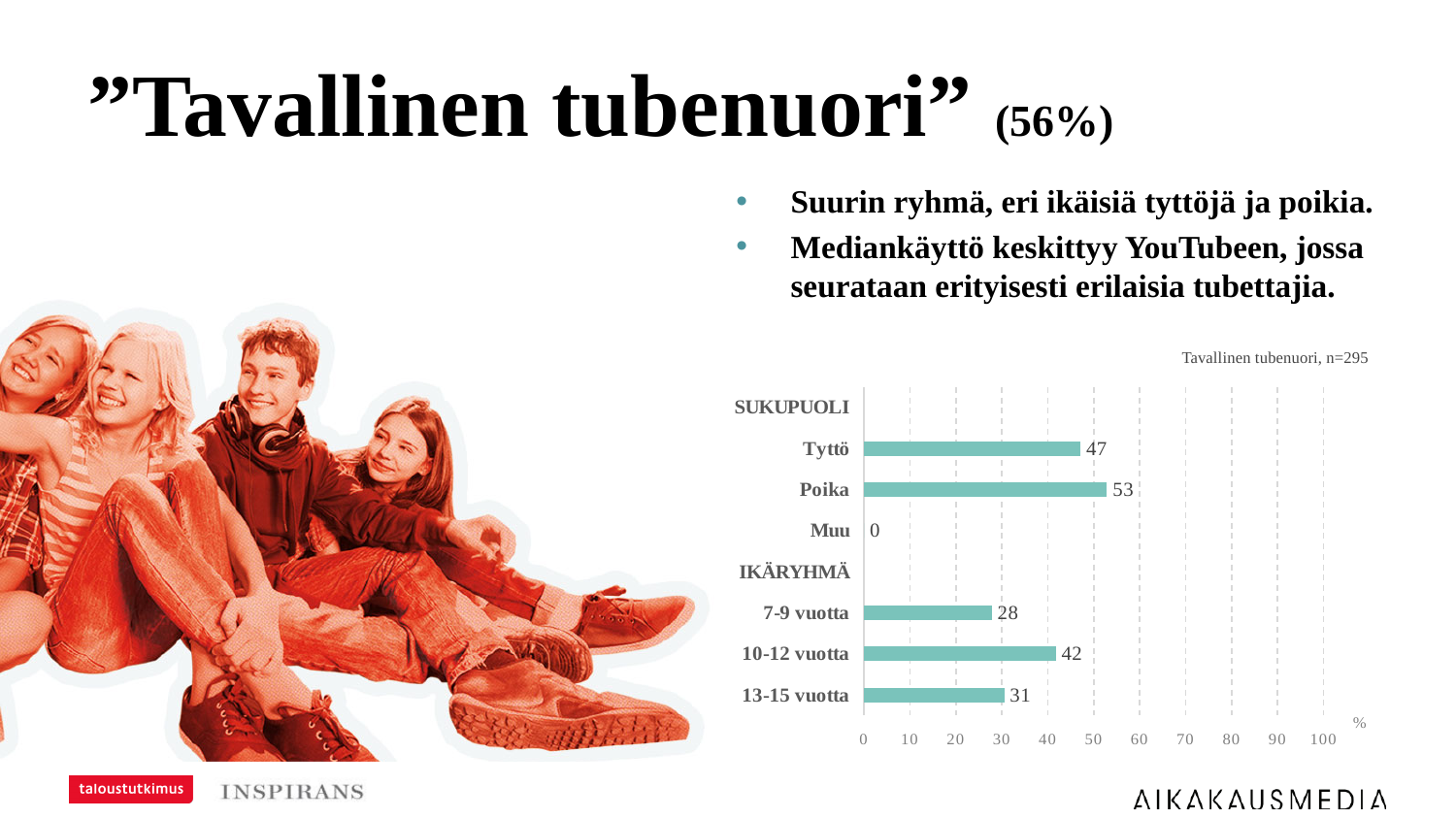
Which category has the highest value in the chart? Poika What kind of chart is shown on the slide? Bar chart What is the value for 13-15 vuotta? 31 What is the difference between the values for 10-12 vuotta and 7-9 vuotta? 14 What is the difference between the values for Poika and Tyttö? 6 Which age group (ikäryhmä) has the lowest value? 7-9 vuotta What is the value for Poika? 53 How many bars with labelled values are plotted in the chart? 6 What is the sample size (n) given in the chart's title? 295 Which is larger, the value for 13-15 vuotta or the value for 7-9 vuotta? 13-15 vuotta What is the value for Tyttö? 47 What is the value for 10-12 vuotta? 42